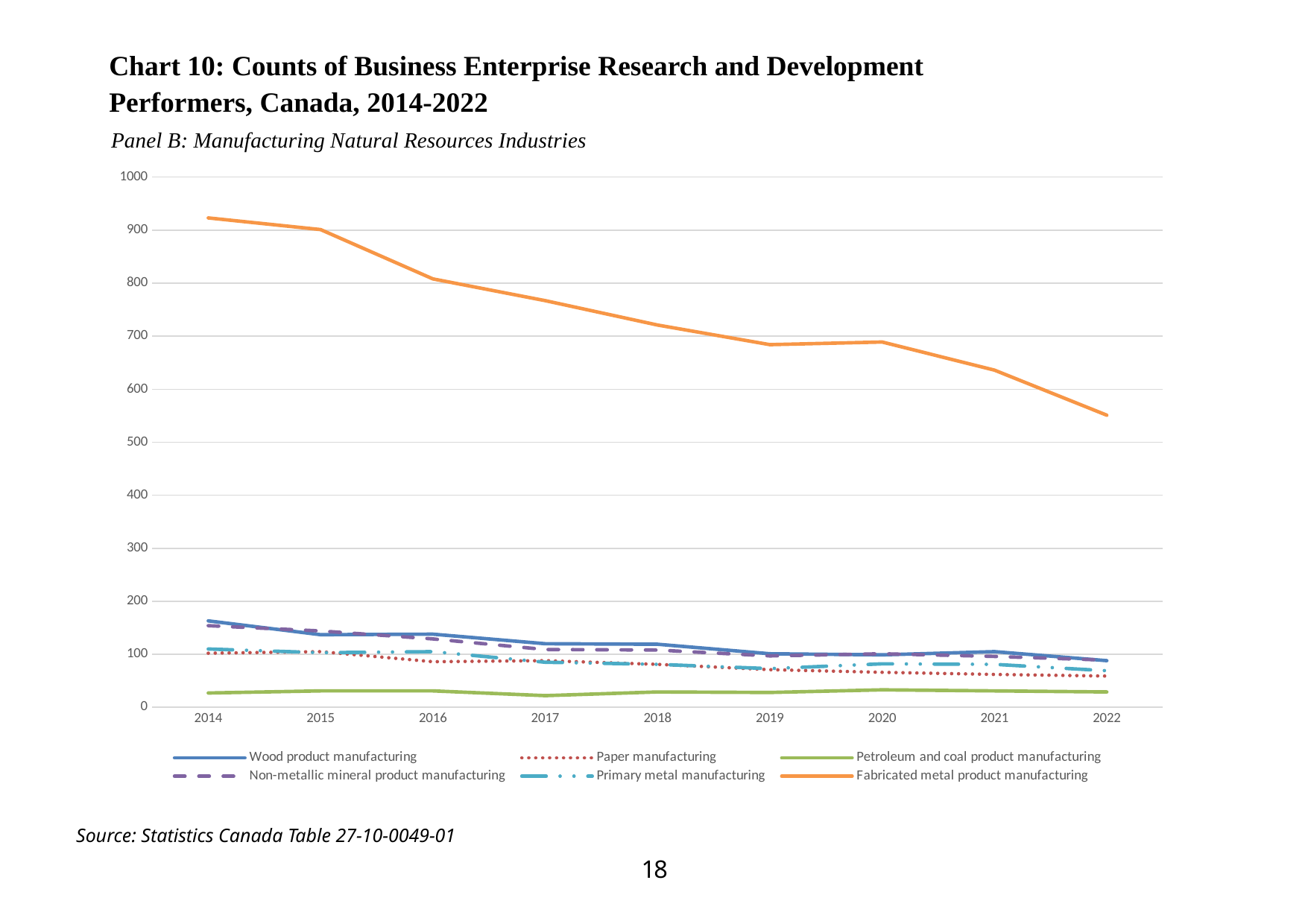
Is the value for Fabricated metal product manufacturing in 2022 greater or less than 600? less How many years are plotted along the x axis? 9 Is the value for Fabricated metal product manufacturing in 2021 greater or less than 600? greater Does the Fabricated metal product manufacturing line rise or fall from 2014 to 2022? fall Is the value for Fabricated metal product manufacturing in 2014 greater or less than 900? greater Which series has the highest values across all years? Fabricated metal product manufacturing What is the panel subtitle shown below the chart title? Panel B: Manufacturing Natural Resources Industries Which series has the lowest values across all years? Petroleum and coal product manufacturing What kind of chart is shown on the slide? line chart How many series does the legend list? 6 In 2014, which is larger: Wood product manufacturing or Petroleum and coal product manufacturing? Wood product manufacturing